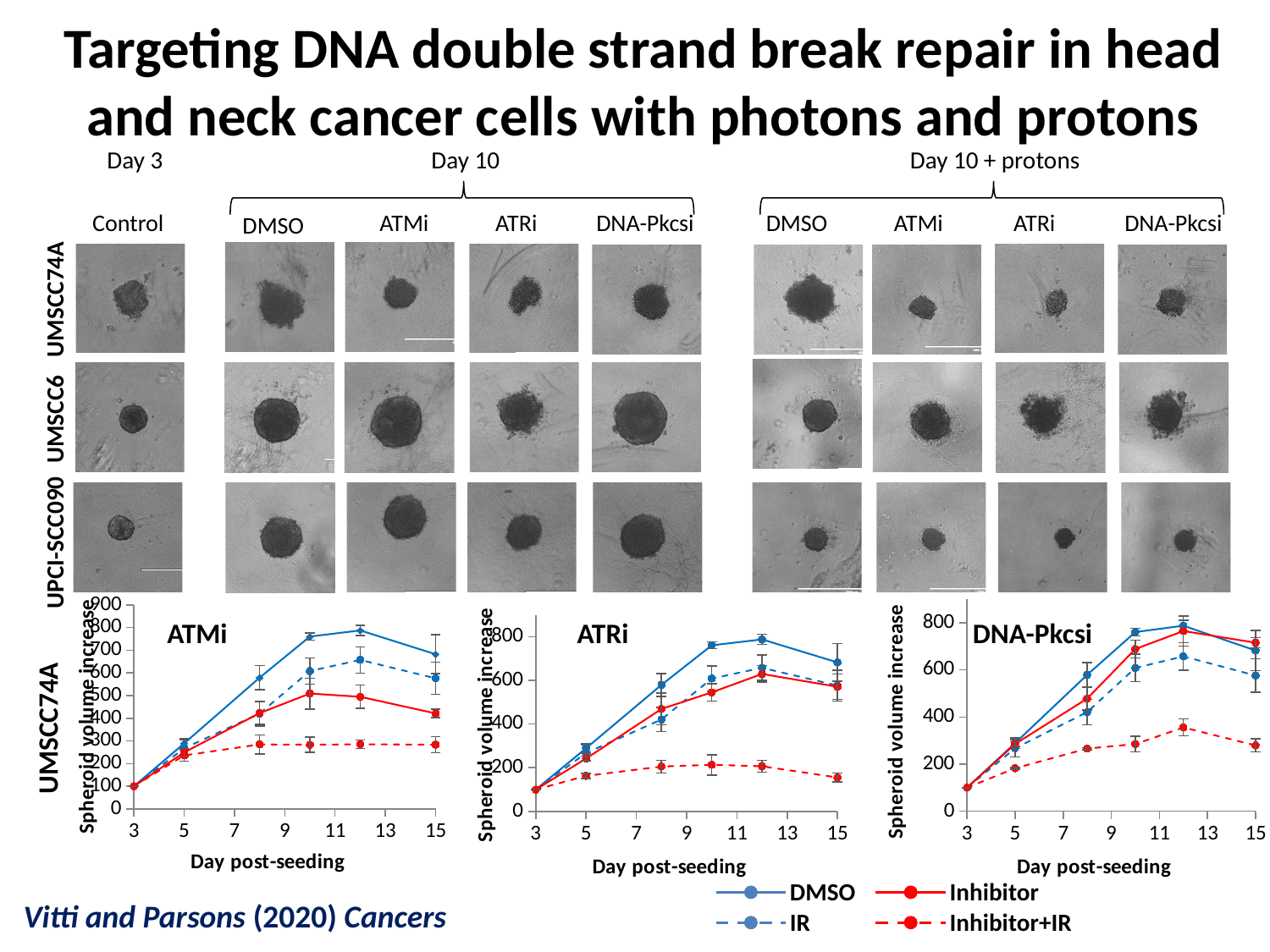
In the DNA-Pkcsi chart, which series has the lowest value at day 12? Inhibitor+IR What kind of chart is the ATMi chart? line chart What is the x-axis title of the DNA-Pkcsi chart? Day post-seeding In the ATMi chart, is the value for DMSO at day 12 greater or less than 700? greater How many time points are plotted for each series in the ATRi chart? 6 How many series does the legend list for the charts? 4 In the ATMi chart, is the value for Inhibitor+IR at day 15 greater or less than 400? less In the ATMi chart, does the DMSO series rise or fall from day 3 to day 12? rise In the ATRi chart, which series has the lowest value at day 15? Inhibitor+IR In the ATRi chart, is the value for DMSO at day 10 greater or less than 600? greater In the ATMi chart, at day 15, which is larger: DMSO or Inhibitor? DMSO